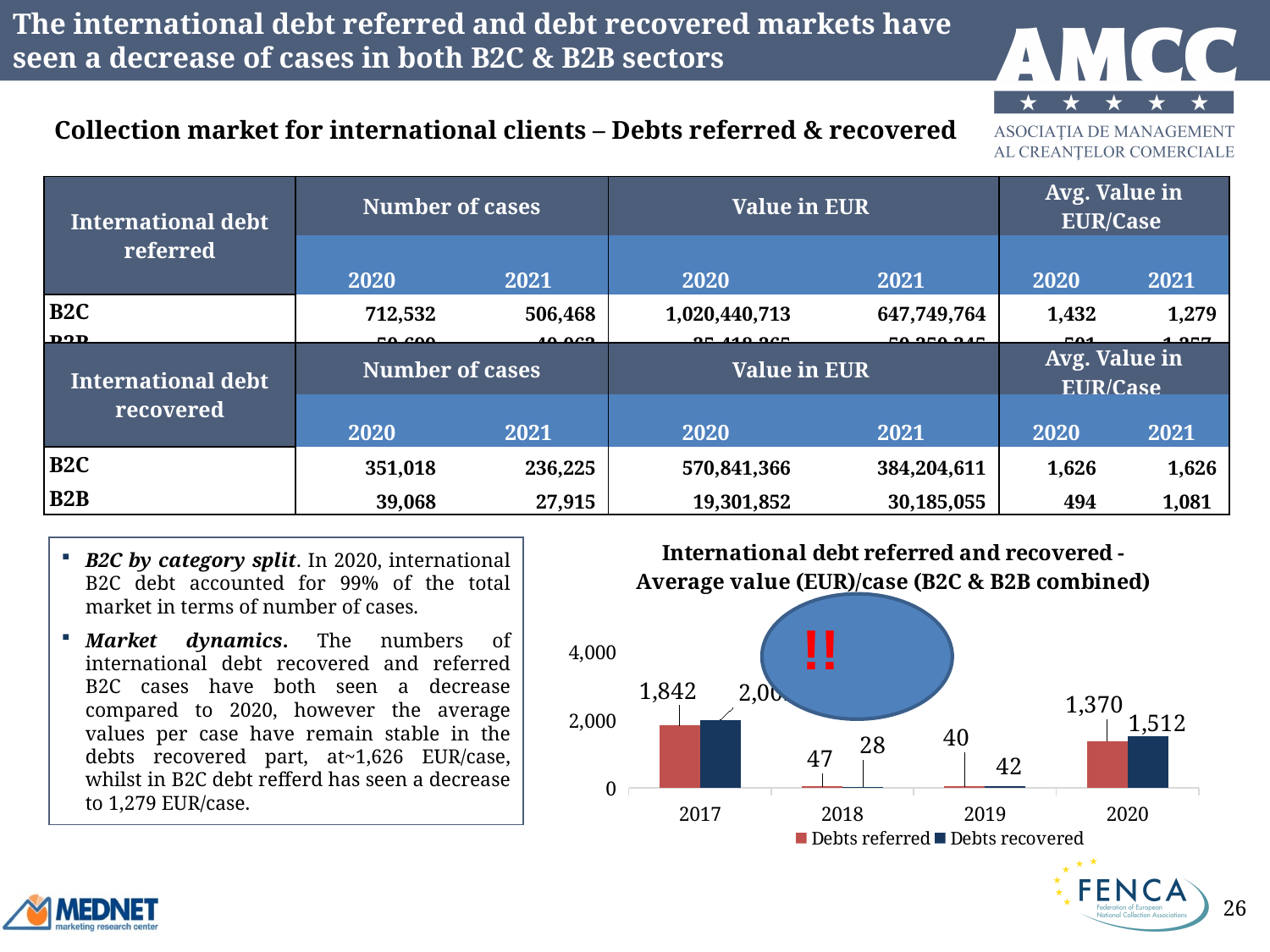
What kind of chart is shown on the slide? Bar chart In which year is the Debts referred value lowest? 2019 What is the value for Debts recovered in 2019? 42 What is the value for Debts recovered in 2020? 1,512 In 2020, which is larger: Debts referred or Debts recovered? Debts recovered How many years are shown on the x axis of the chart? 4 What is the value for Debts recovered in 2018? 28 What is the value for Debts referred in 2017? 1,842 What is the difference between Debts recovered and Debts referred in 2020? 142 What is the value for Debts referred in 2020? 1,370 What is the value for Debts referred in 2018? 47 How many series does the chart's legend list? 2